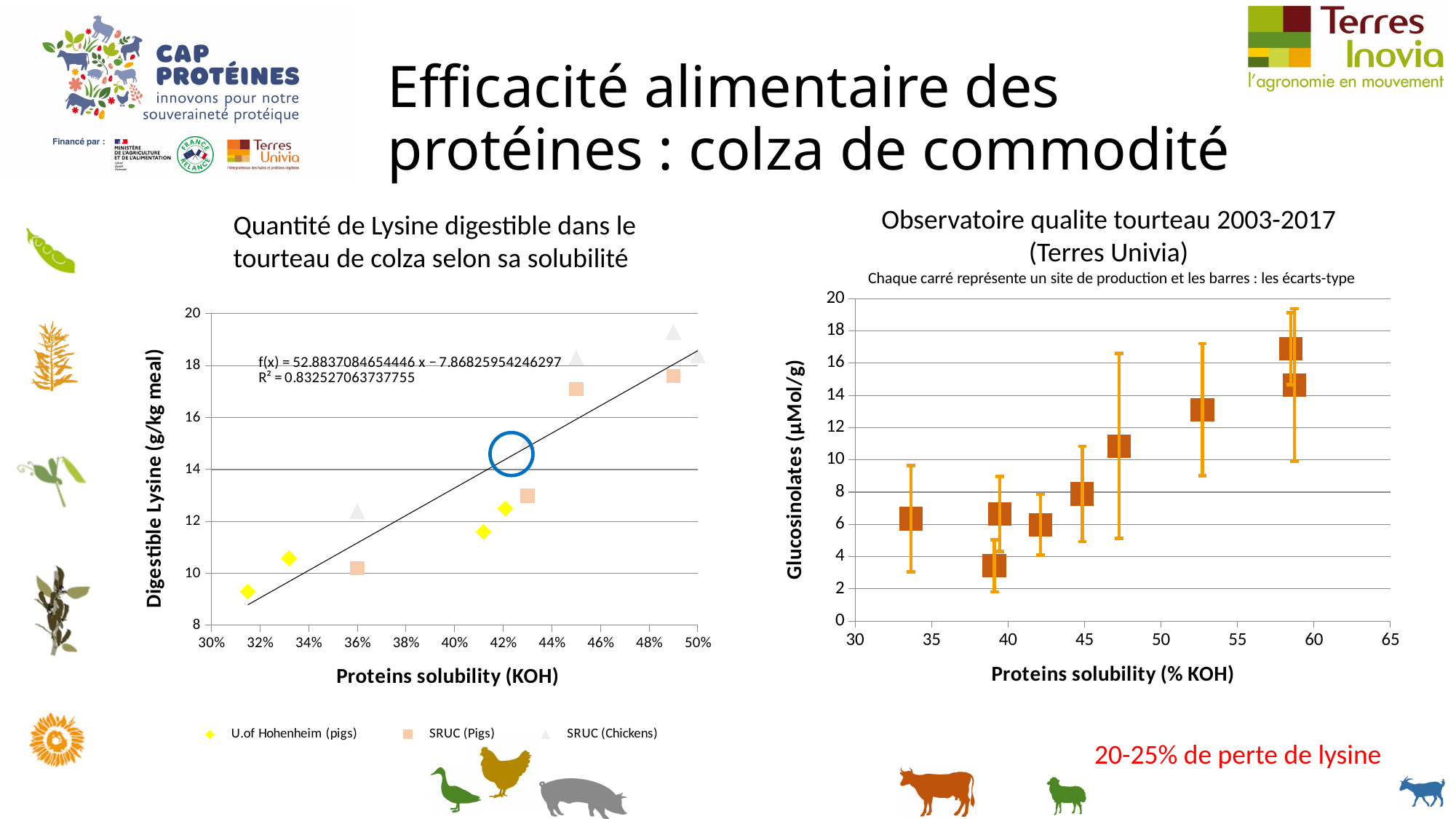
In the right chart 'Observatoire qualite tourteau 2003-2017', is the glucosinolate value of the lowest square near 39% solubility greater or less than 5? less In the left chart, do the digestible lysine values rise or fall as protein solubility increases along the x axis? rise In the left chart, is the digestible lysine value of the lowest U.of Hohenheim (pigs) point greater or less than 10? less In the left chart, how many U.of Hohenheim (pigs) points are plotted? 4 In the left chart, is the digestible lysine value of the highest SRUC (Chickens) point greater or less than 18? greater What kind of chart is the left chart titled 'Quantité de Lysine digestible dans le tourteau de colza selon sa solubilité'? scatter chart In the right chart 'Observatoire qualite tourteau 2003-2017', do glucosinolate values rise or fall as protein solubility increases along the x axis? rise What is the y-axis title of the left chart? Digestible Lysine (g/kg meal) How many series does the legend of the left chart list? 3 What is the R² value printed on the left chart? 0.832527063737755